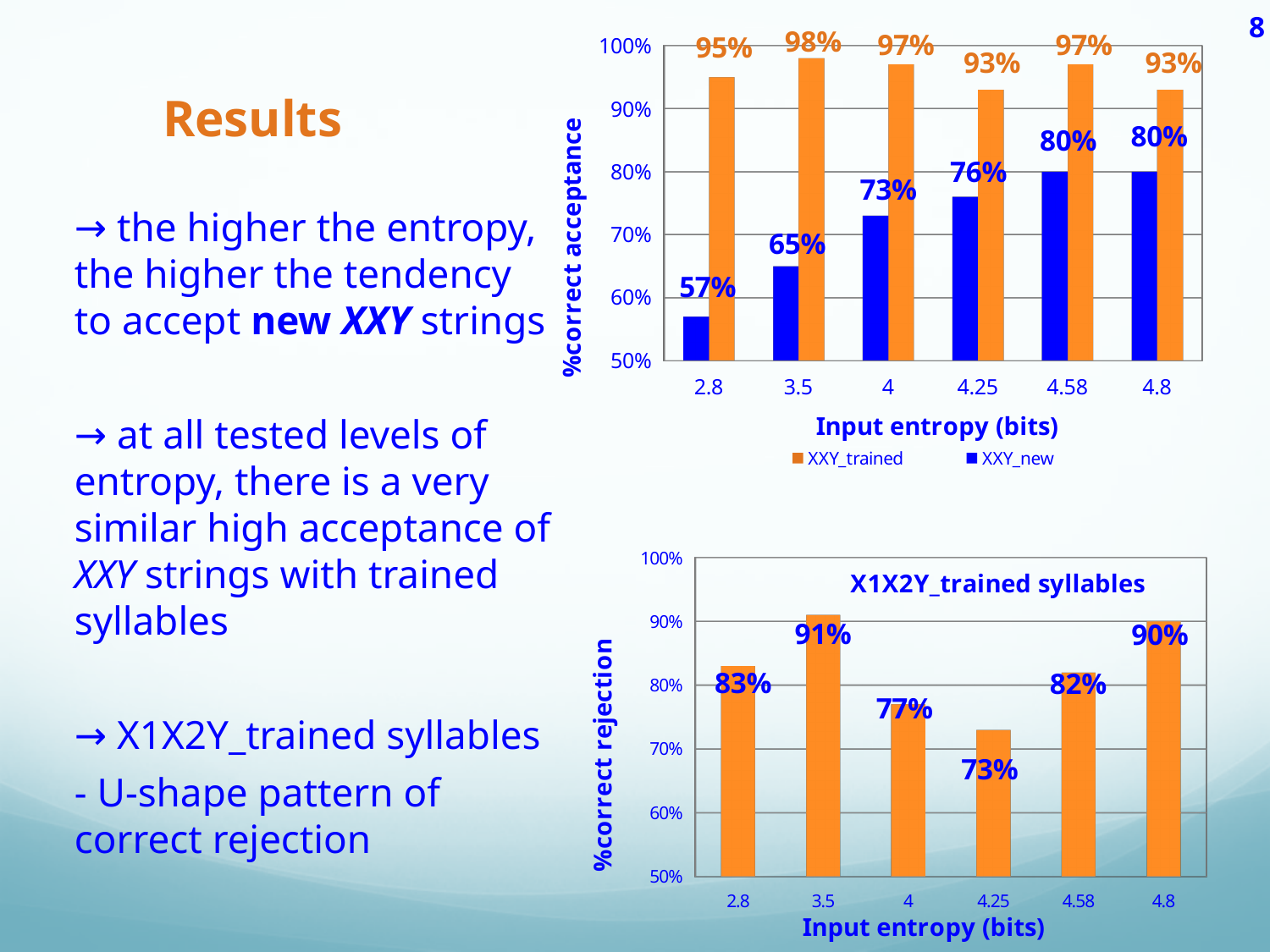
In the top chart (%correct acceptance), what is the value for XXY_new at input entropy 2.8 bits? 57% How many input entropy categories are shown on the x axis of the bottom chart (%correct rejection)? 6 In the top chart (%correct acceptance), at which input entropy is the XXY_new value lowest? 2.8 In the top chart (%correct acceptance), do the XXY_new values rise or fall as input entropy increases? rise In the bottom chart (%correct rejection), what is the difference between the values at input entropy 3.5 and 4.25 bits? 18% How many series does the legend of the top chart (%correct acceptance) list? 2 What type of chart is the bottom chart (%correct rejection)? bar chart In the bottom chart (%correct rejection), at which input entropy is the value highest? 3.5 In the top chart (%correct acceptance), what is the difference between XXY_trained and XXY_new at input entropy 4 bits? 24% In the top chart (%correct acceptance), what is the value for XXY_trained at input entropy 3.5 bits? 98% In the top chart (%correct acceptance), which series has the larger value at input entropy 4.25 bits, XXY_trained or XXY_new? XXY_trained In the bottom chart (%correct rejection), what is the value at input entropy 4.25 bits? 73%